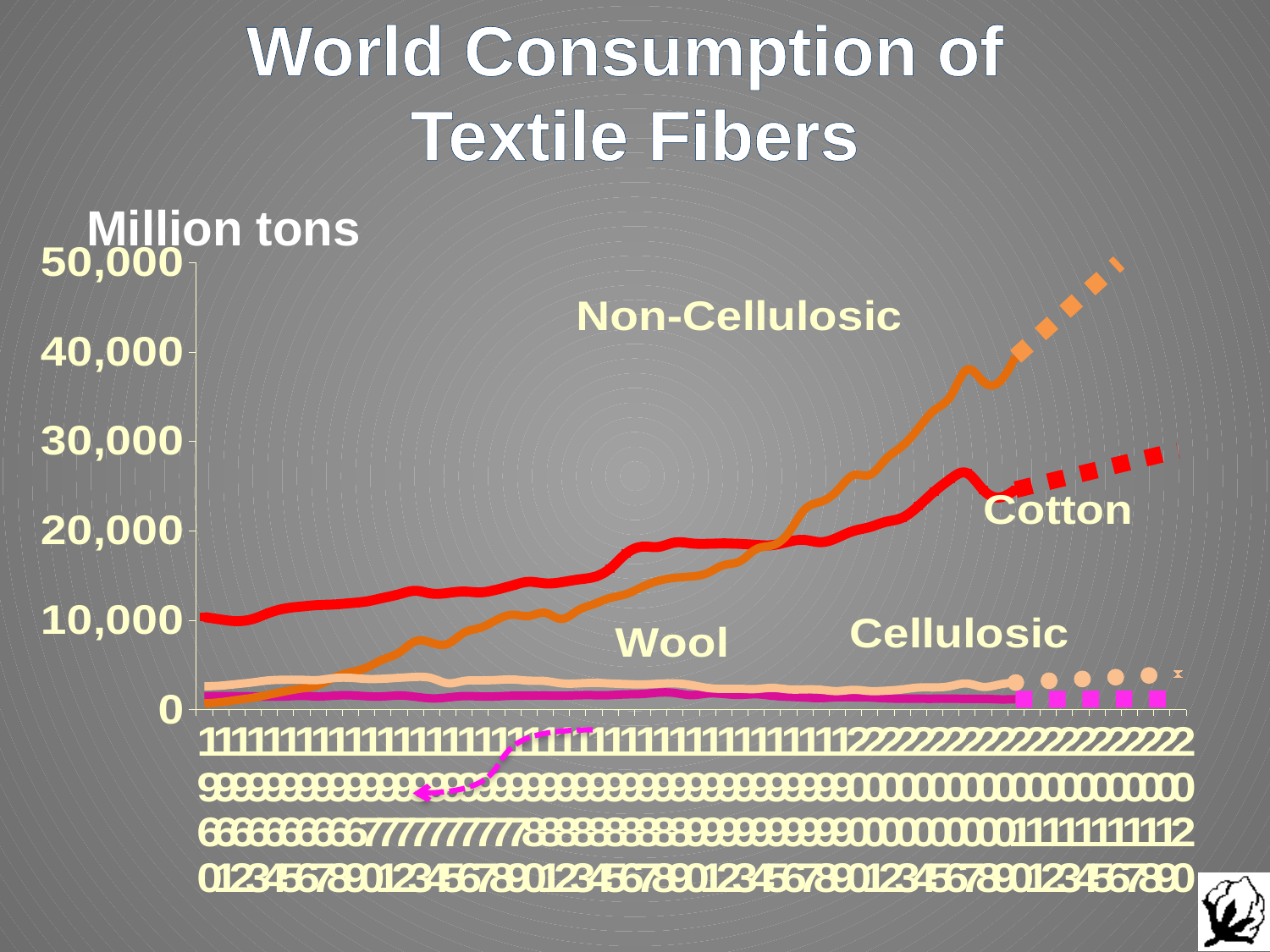
How many fiber series are plotted on the chart? 4 Which series has the lowest value at the right end of the chart? Wool What is the title of the chart? World Consumption of Textile Fibers Which series reaches the highest value on the chart? Non-Cellulosic Does the Non-Cellulosic line rise or fall along the x axis overall? rise At the right end of the chart, which is larger, Non-Cellulosic or Cotton? Non-Cellulosic Is the Wool line ever greater or less than 10,000? less Is the value of the Cotton line at the right end of the chart greater or less than 20,000? greater What kind of chart is shown on the slide? line chart Is the peak value of the solid Non-Cellulosic line greater or less than 30,000? greater What unit is shown for the y axis? Million tons At the left end of the chart, which is larger, Cotton or Non-Cellulosic? Cotton